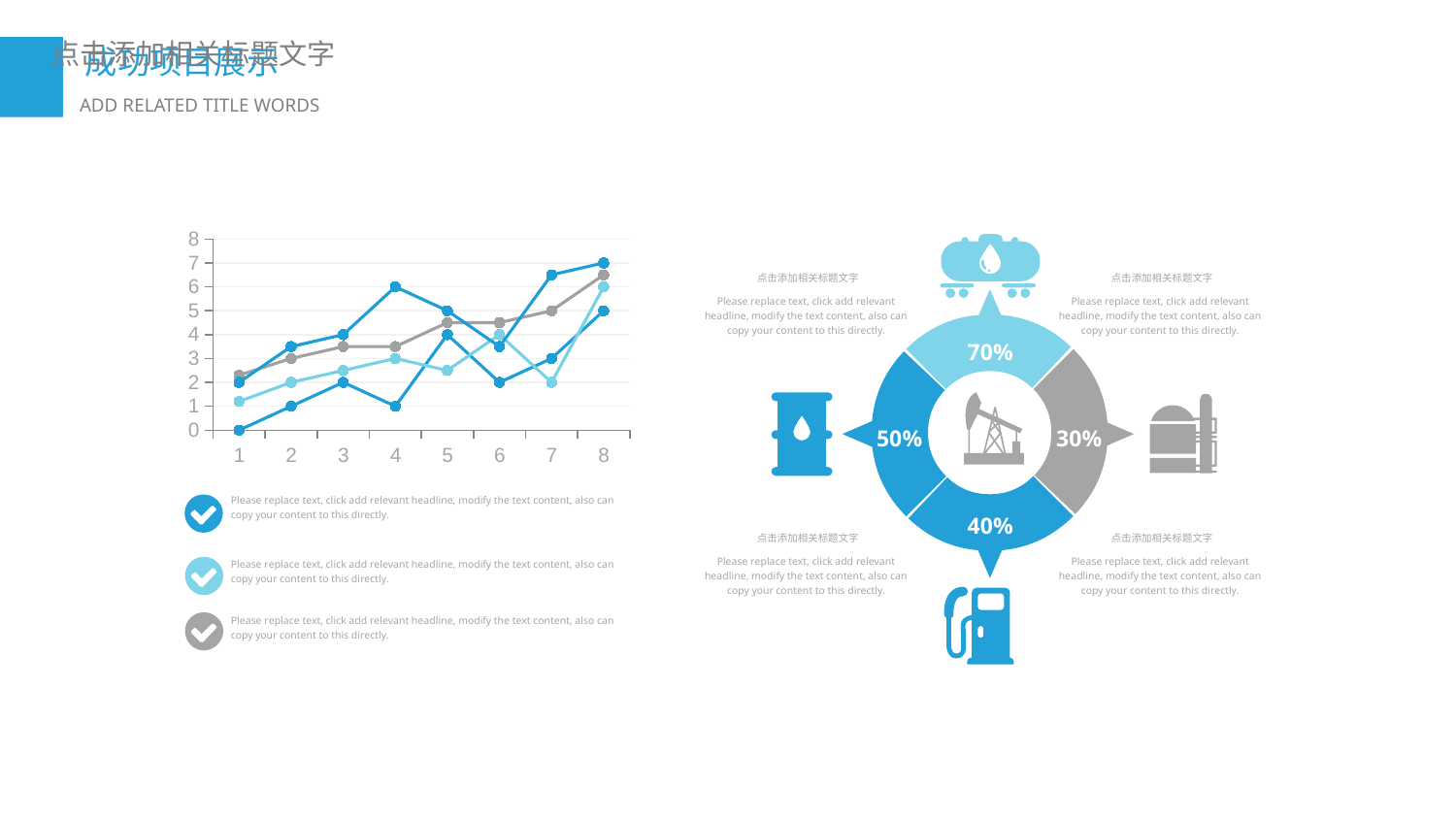
In the ring graphic on the right, which segment has the largest percentage? 70% In the line chart on the left, at which x-axis point does the highest plotted value occur? 8 What kind of chart is shown on the left of the slide? line chart In the line chart on the left, what is the highest value shown on the y axis? 8 In the ring graphic on the right, which segment has the smallest percentage? 30% In the line chart on the left, is the highest plotted value at x = 8 greater or less than 6? greater In the line chart on the left, is the lowest plotted value at x = 1 greater or less than 1? less In the ring graphic on the right, what is the difference between the top segment (70%) and the right segment (30%)? 40% In the ring graphic on the right, which is larger, the left segment or the bottom segment? the left segment (50%) In the ring graphic on the right, how many percentage segments are shown? 4 In the line chart on the left, how many points are labelled along the x axis? 8 In the line chart on the left, do the lines generally rise or fall from x = 1 to x = 8? rise